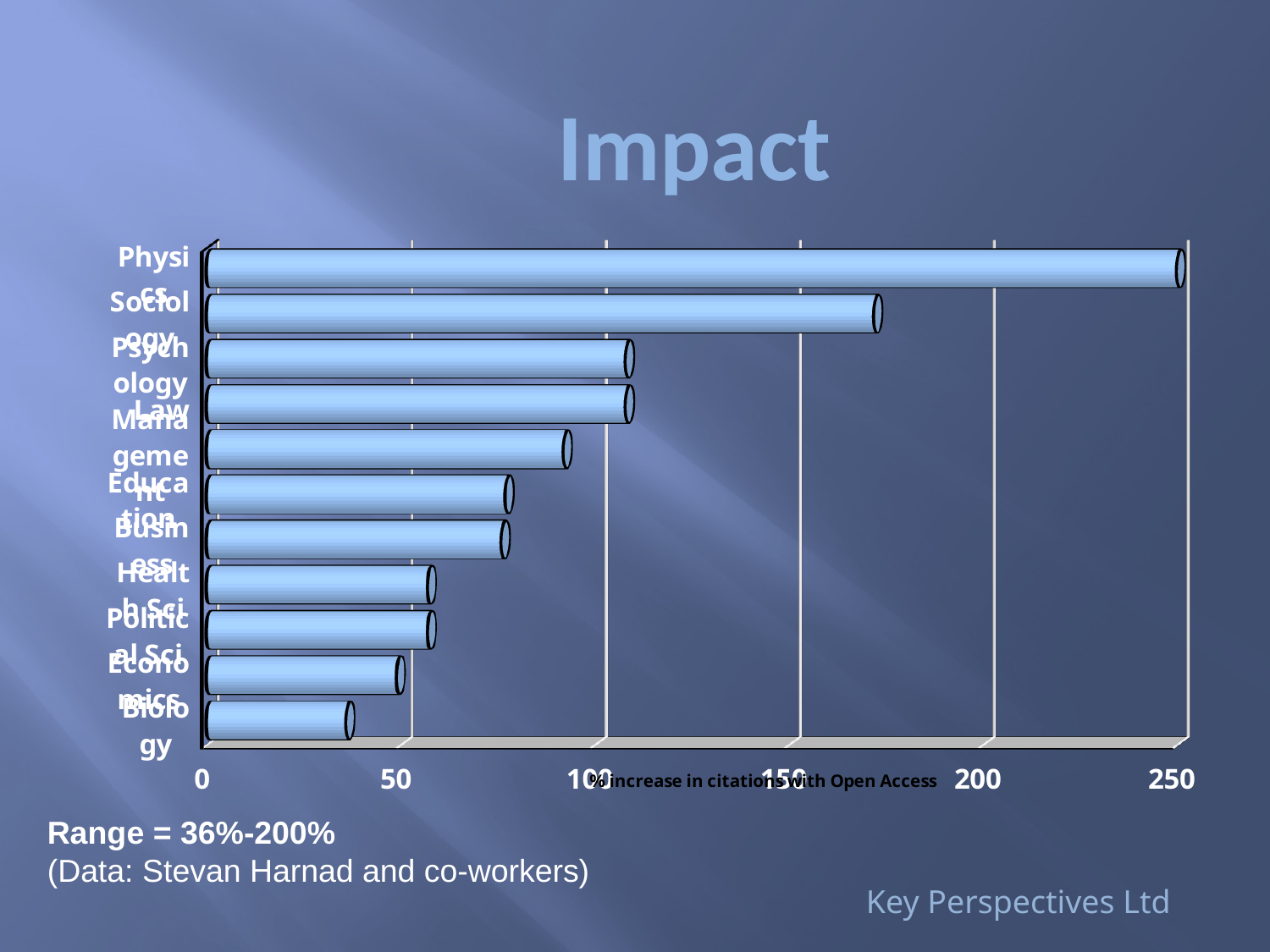
Is the value for Physics greater or less than 200? greater Which category has the lowest value in the chart? Biology Is the value for Biology greater or less than 50? less Which has the larger value, Economics or Education? Education How many categories (bars) does the chart show? 11 What is the label on the horizontal axis of the chart? % increase in citations with Open Access Which has the larger value, Sociology or Law? Sociology Is the value for Sociology greater or less than 150? greater What kind of chart is shown on the slide? bar chart Which category has the highest value in the chart? Physics What is the title of the slide containing the chart? Impact